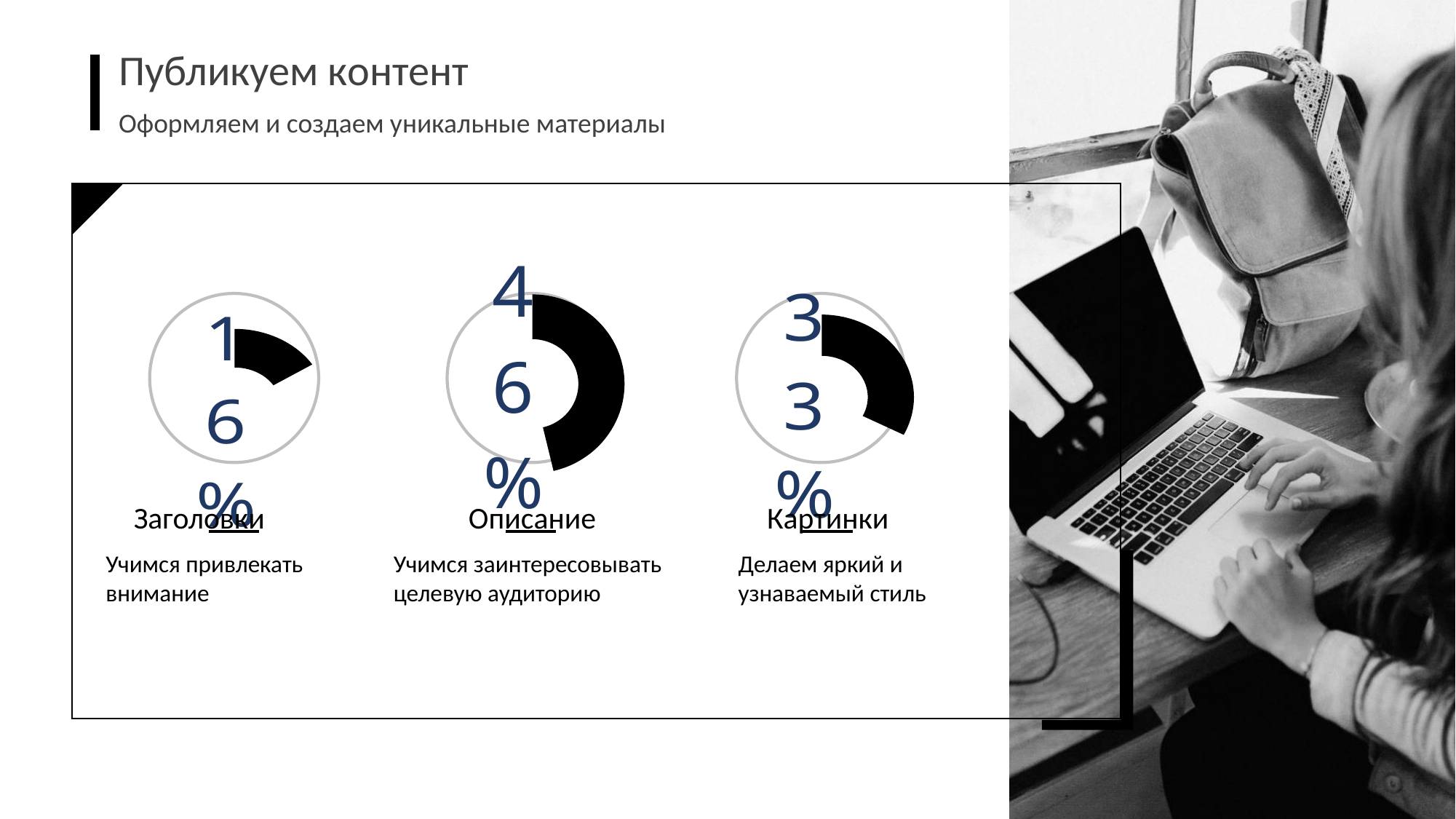
What is the difference between the percentages for Описание and Картинки? 13% What percentage is shown in the donut chart labelled Заголовки? 16% What percentage is shown in the donut chart labelled Описание? 46% What is the title of the slide containing the three donut charts? Публикуем контент Which has the larger percentage, Картинки or Заголовки? Картинки What percentage is shown in the donut chart labelled Картинки? 33% Is the percentage shown for Описание greater or less than 50%? less How many donut charts are shown on the slide? 3 Which of the three donut charts shows the highest percentage? Описание What is the difference between the percentages for Описание and Заголовки? 30% What kind of chart is used to show the percentages on the slide? donut chart Which of the three donut charts shows the lowest percentage? Заголовки